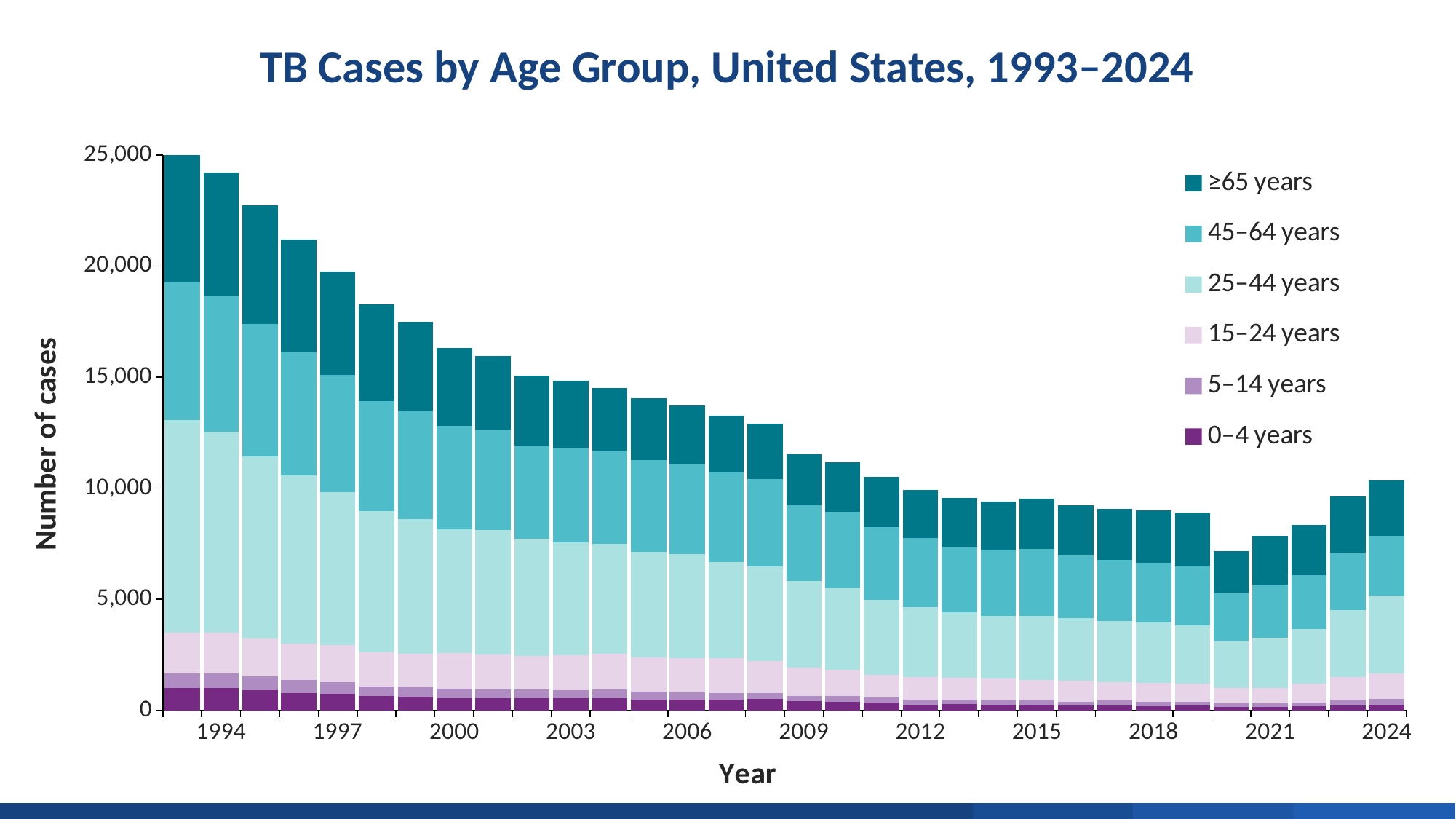
Which year has the lowest total number of TB cases? 2020 What is the label on the y axis? Number of cases Do total TB cases rise or fall from 1993 to 2020? Fall How many years (bars) are plotted in the chart? 32 Is the total number of cases in 2009 greater or less than 15,000? less How many age groups does the legend list? 6 Is the total number of cases in 2020 greater or less than 10,000? less What kind of chart is shown on the slide? Stacked bar chart Which year has a larger total number of cases, 1993 or 2024? 1993 What is the title of the chart? TB Cases by Age Group, United States, 1993–2024 Which year has the highest total number of TB cases? 1993 Is the total number of cases in 1996 greater or less than 20,000? greater